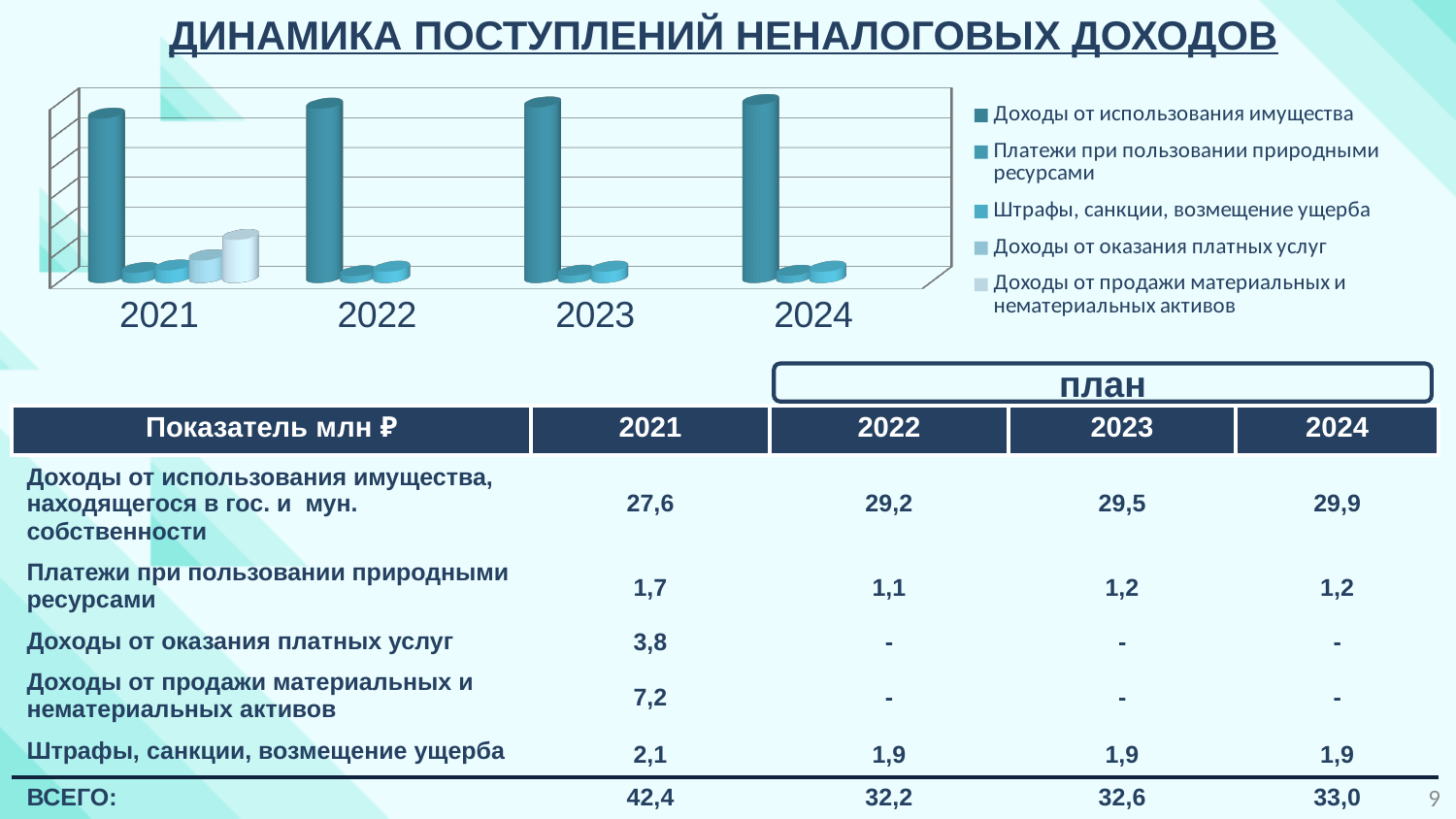
What kind of chart is shown on the slide? bar chart Which is larger: Доходы от использования имущества in 2021 or in 2024? 2024 Which series has the tallest bar in every year of the chart? Доходы от использования имущества According to the table, what is the value of Доходы от использования имущества for 2024 (млн ₽)? 29,9 In which year does the chart show bars for Доходы от оказания платных услуг and Доходы от продажи материальных и нематериальных активов? 2021 How many years are shown along the x axis of the chart? 4 What is the title of the slide? ДИНАМИКА ПОСТУПЛЕНИЙ НЕНАЛОГОВЫХ ДОХОДОВ According to the table, what is the value of Доходы от использования имущества for 2021 (млн ₽)? 27,6 What is the difference between the 2024 and 2021 values of Доходы от использования имущества in the table? 2,3 Does the value of Доходы от использования имущества rise or fall from 2021 to 2024? rise What is the total (ВСЕГО) of non-tax revenues for 2021 in the table? 42,4 How many series does the chart legend list? 5